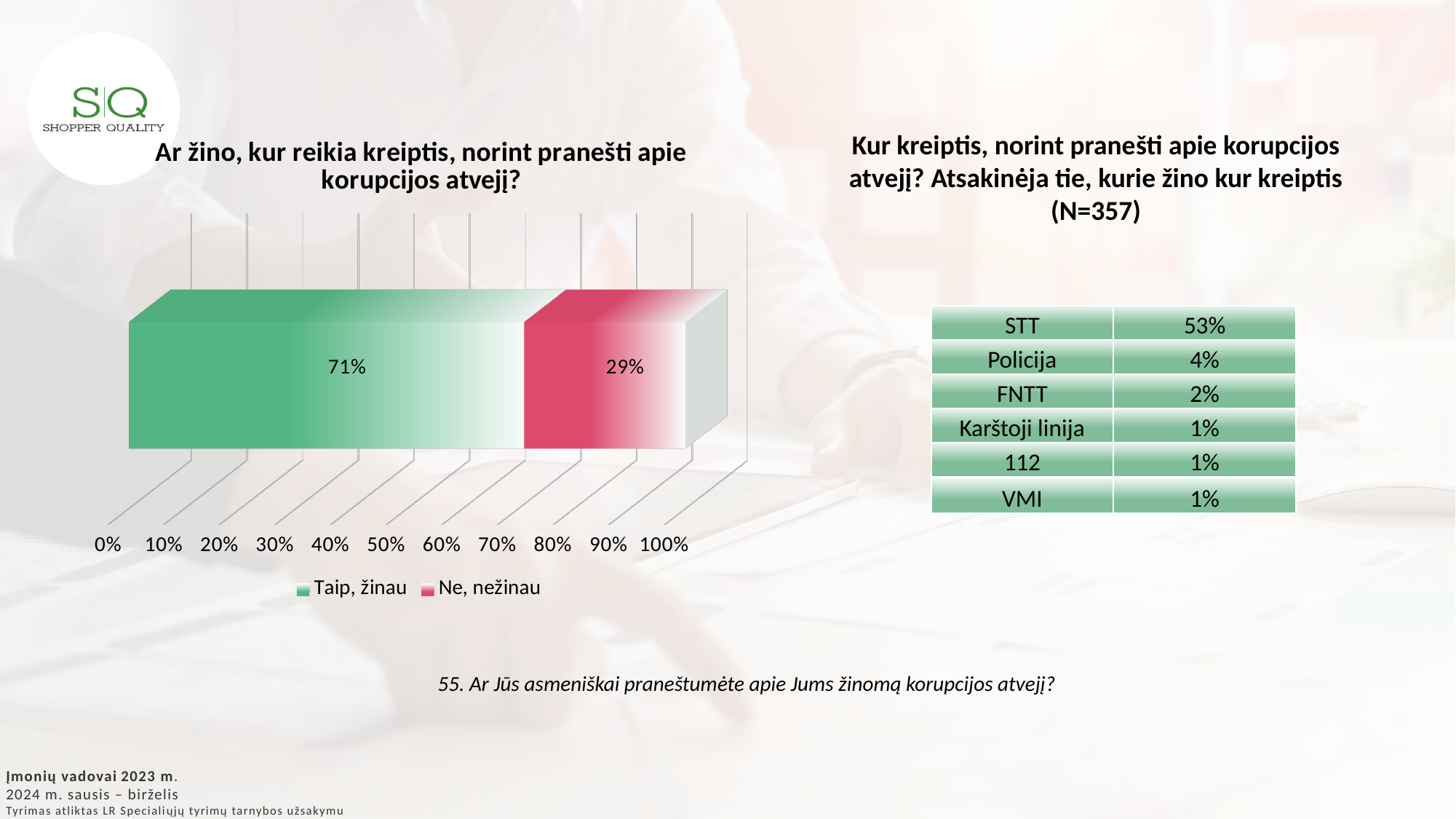
In the chart "Ar žino, kur reikia kreiptis, norint pranešti apie korupcijos atvejį?", is the value for "Taip, žinau" greater or less than 70%? greater In the chart "Ar žino, kur reikia kreiptis, norint pranešti apie korupcijos atvejį?", which series has the larger value? Taip, žinau How many series does the legend of the chart "Ar žino, kur reikia kreiptis, norint pranešti apie korupcijos atvejį?" list? 2 In the chart "Ar žino, kur reikia kreiptis, norint pranešti apie korupcijos atvejį?", which series has the smaller value? Ne, nežinau What kind of chart is shown under the title "Ar žino, kur reikia kreiptis, norint pranešti apie korupcijos atvejį?"? bar chart In the chart "Ar žino, kur reikia kreiptis, norint pranešti apie korupcijos atvejį?", what colour is the "Ne, nežinau" segment? red In the chart "Ar žino, kur reikia kreiptis, norint pranešti apie korupcijos atvejį?", what is the value for "Ne, nežinau"? 29% In the chart "Ar žino, kur reikia kreiptis, norint pranešti apie korupcijos atvejį?", what is the difference between the "Taip, žinau" and "Ne, nežinau" values? 42% In the chart "Ar žino, kur reikia kreiptis, norint pranešti apie korupcijos atvejį?", what is the value for "Taip, žinau"? 71% In the chart "Ar žino, kur reikia kreiptis, norint pranešti apie korupcijos atvejį?", is the value for "Ne, nežinau" greater or less than 30%? less In the chart "Ar žino, kur reikia kreiptis, norint pranešti apie korupcijos atvejį?", what is the total of the two stacked segments? 100% In the chart "Ar žino, kur reikia kreiptis, norint pranešti apie korupcijos atvejį?", is the value for "Taip, žinau" larger than the value for "Ne, nežinau"? Yes